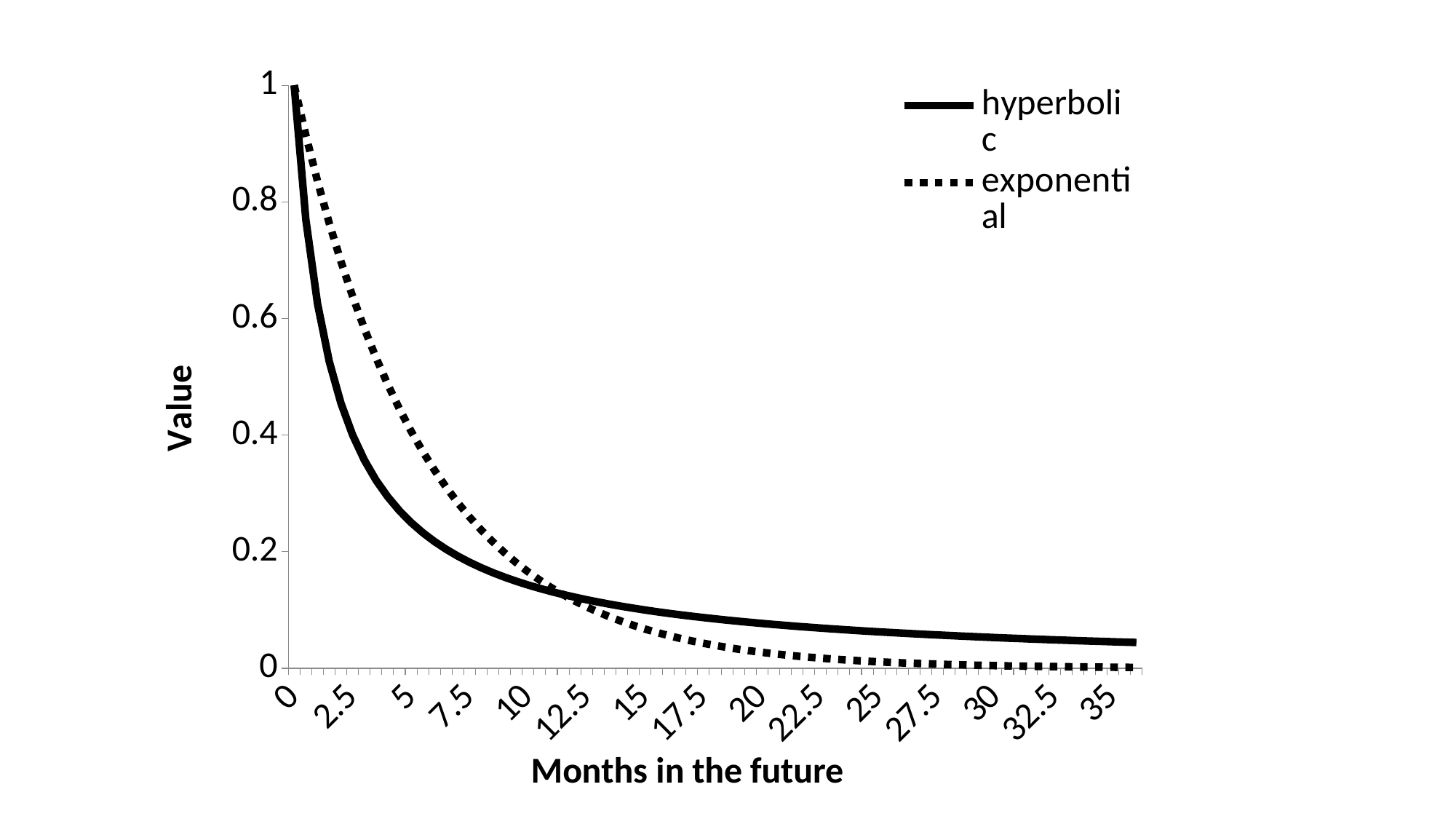
Is the value of the exponential series at 25 months greater or less than 0.2? less What is the value of the hyperbolic series at 0 months in the future? 1 What is the value of the exponential series at 0 months in the future? 1 Do the values of the hyperbolic series rise or fall as months in the future increase? fall Is the value of the hyperbolic series at 5 months greater or less than 0.4? less How many series does the legend list? 2 At 25 months in the future, which series has the higher value, hyperbolic or exponential? hyperbolic Which series is drawn with a dotted line? exponential What is the title of the x axis? Months in the future What kind of chart is shown on the slide? line chart At 5 months in the future, which series has the higher value, hyperbolic or exponential? exponential